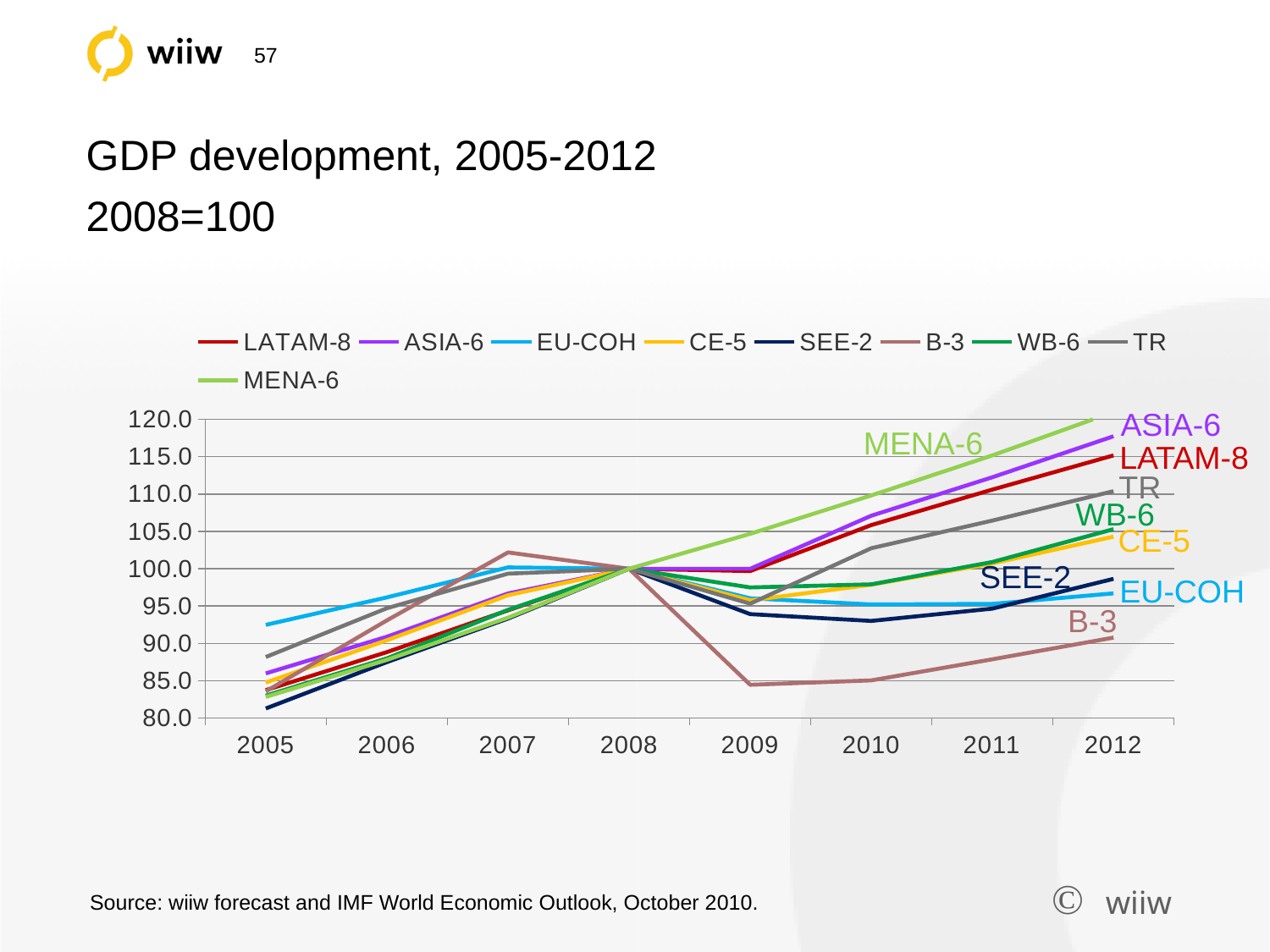
Is the value for MENA-6 in 2012 greater or less than 115? greater In 2012, which is higher, TR or WB-6? TR Does the B-3 line rise or fall from 2008 to 2009? fall What is the value of LATAM-8 in 2008? 100.0 How many years are shown on the x axis? 8 Is the value for B-3 in 2009 greater or less than 90? less Which series has the highest value in 2005? EU-COH What kind of chart is shown on the slide? line chart Which series has the highest value in 2012? MENA-6 How many series does the legend list? 9 What is the title of the chart? GDP development, 2005-2012 Which series has the lowest value in 2012? B-3